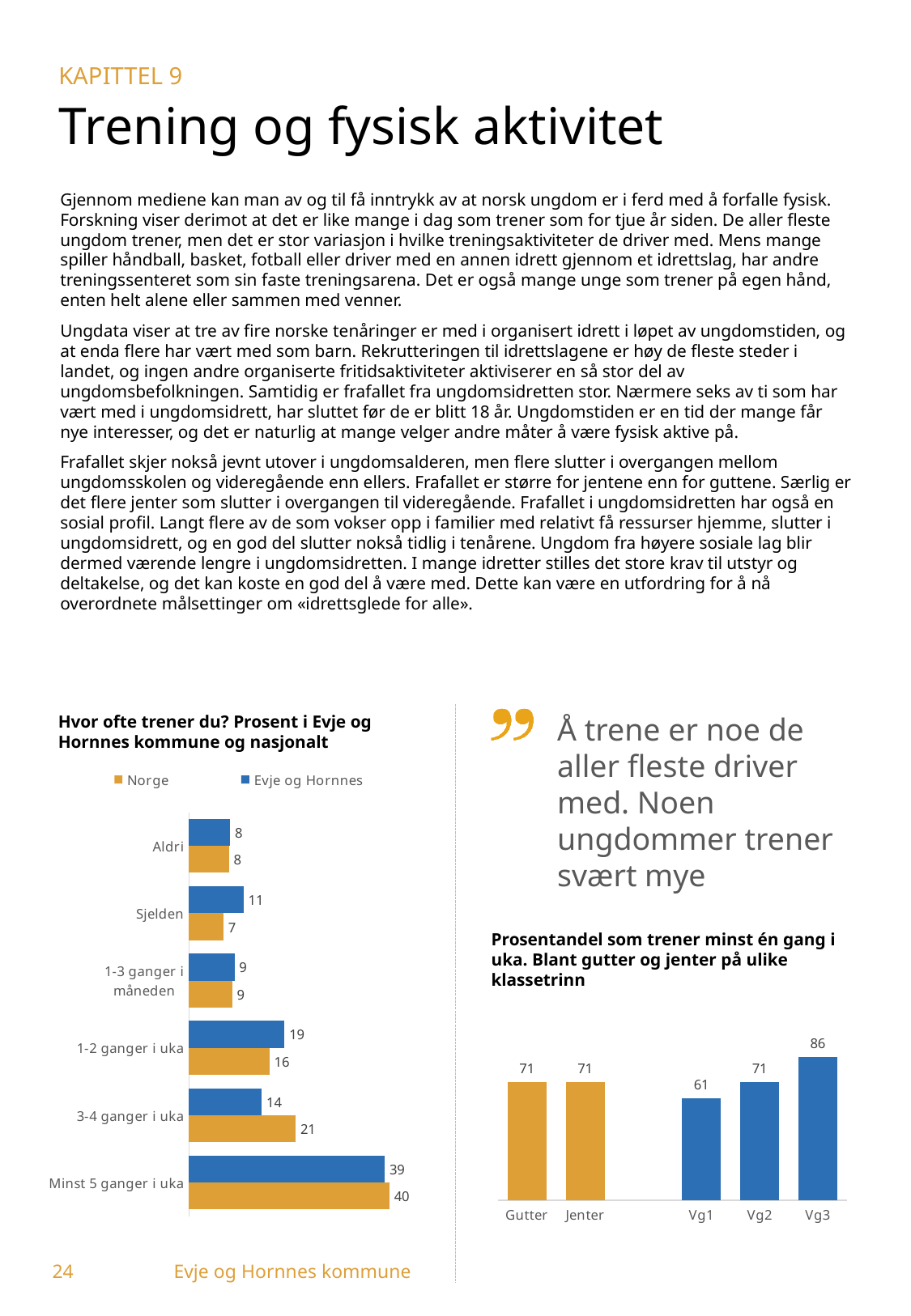
In the chart 'Hvor ofte trener du?', which is larger for 'Sjelden': Norge or Evje og Hornnes? Evje og Hornnes In the chart 'Hvor ofte trener du?', which category has the highest value for Norge? Minst 5 ganger i uka In the chart 'Prosentandel som trener minst én gang i uka', which category has the highest value? Vg3 In the chart 'Hvor ofte trener du?', what is the difference between Norge and Evje og Hornnes for '3-4 ganger i uka'? 7 In the chart 'Hvor ofte trener du?', how many series does the legend list? 2 What kind of chart is 'Hvor ofte trener du?'? Bar chart In the chart 'Prosentandel som trener minst én gang i uka', what is the difference between Vg3 and Vg1? 25 In the chart 'Hvor ofte trener du?', what is the value for Norge for '3-4 ganger i uka'? 21 In the chart 'Prosentandel som trener minst én gang i uka', what is the value for Vg1? 61 In the chart 'Prosentandel som trener minst én gang i uka', do the values rise or fall from Vg1 to Vg3? Rise In the chart 'Hvor ofte trener du?', what is the value for Evje og Hornnes for 'Minst 5 ganger i uka'? 39 In the chart 'Hvor ofte trener du?', how many categories are shown? 6